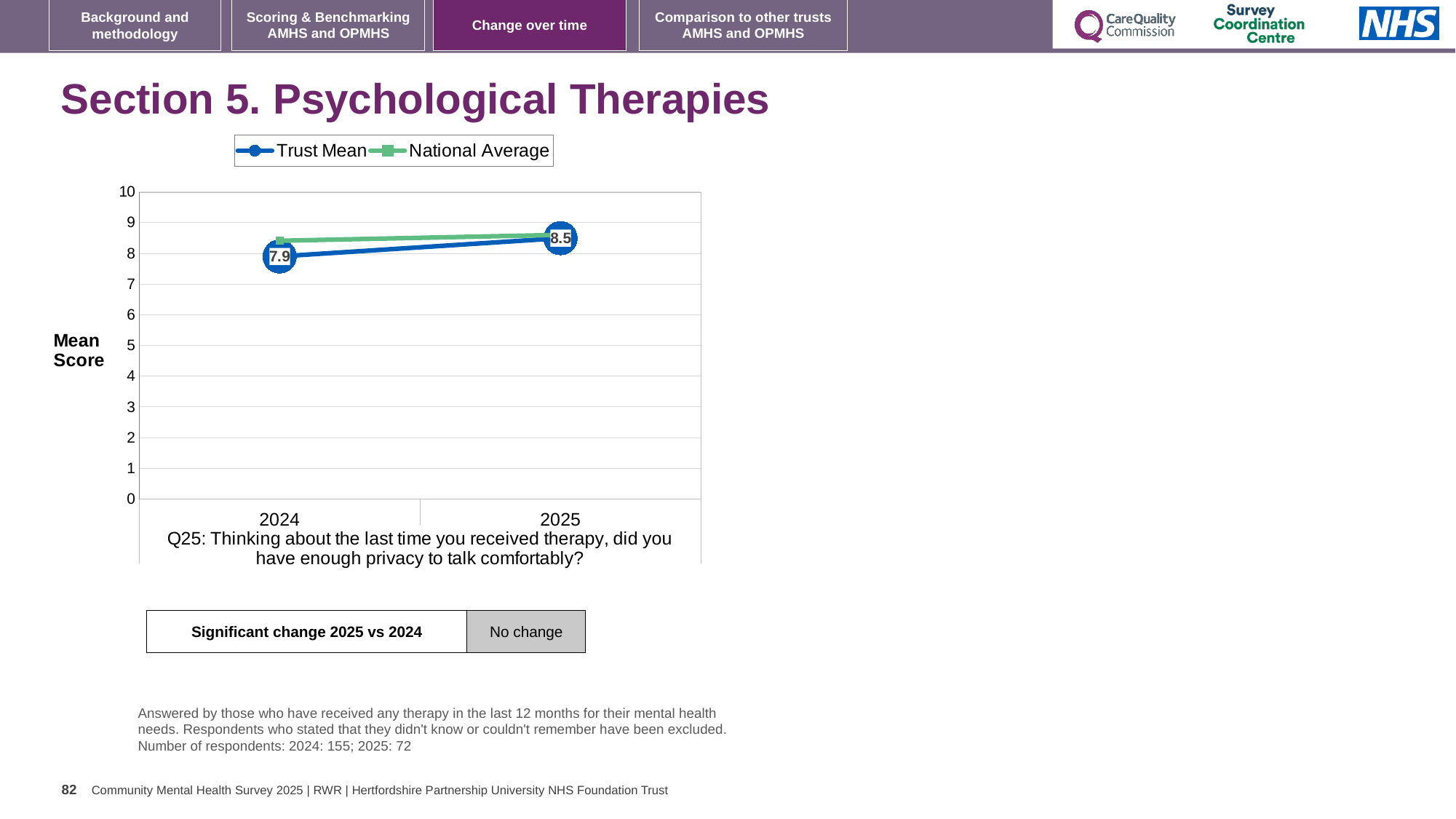
Is the National Average value for 2025 greater or less than 9? less Is the National Average value for 2024 greater or less than 8? greater What is the label on the y axis of the chart? Mean Score What is the Trust Mean value for 2024? 7.9 Does the Trust Mean rise or fall from 2024 to 2025? rise By how much did the Trust Mean change from 2024 to 2025? 0.6 In which year is the Trust Mean higher? 2025 In 2024, which is larger: the Trust Mean or the National Average? National Average How many series does the chart legend list? 2 What is the Trust Mean value for 2025? 8.5 What kind of chart is shown on the slide? line chart How many years are shown on the x axis of the chart? 2